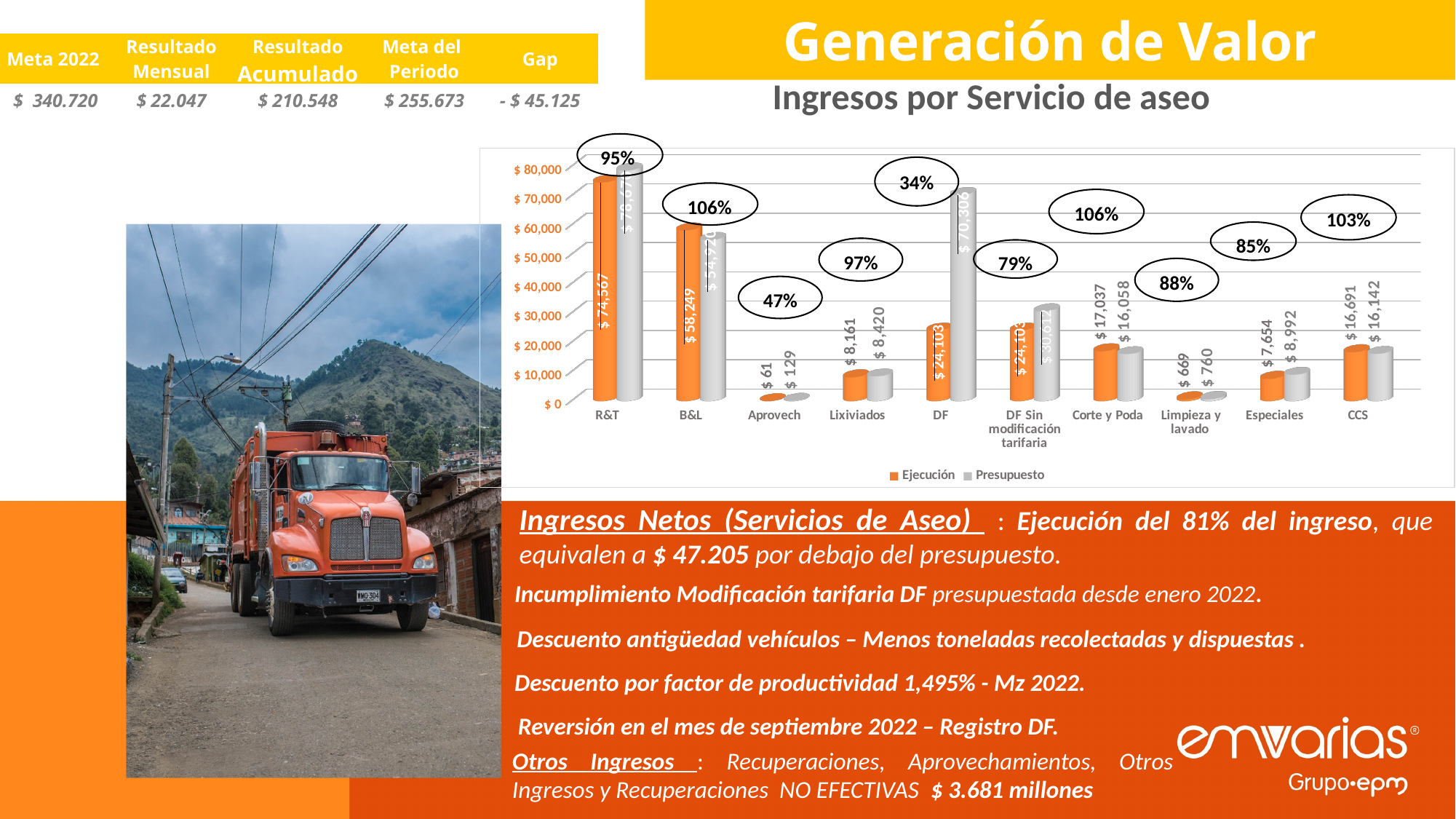
What is the Presupuesto value for Limpieza y lavado? $ 760 What is the Ejecución value for Corte y Poda? $ 17,037 What is the difference between the Presupuesto and Ejecución values for Especiales? $ 1,338 What is the Presupuesto value for DF? $ 70,306 Which category has the lowest Ejecución value? Aprovech For CCS, which is larger, Ejecución or Presupuesto? Ejecución How many categories are shown on the x axis of the 'Ingresos por Servicio de aseo' chart? 10 What kind of chart is shown under the title 'Ingresos por Servicio de aseo'? bar chart What is the Ejecución value for Lixiviados? $ 8,161 Is the Presupuesto value for R&T greater or less than $ 70,000? greater How many series does the legend of the 'Ingresos por Servicio de aseo' chart list? 2 Which category has the highest Ejecución value? R&T